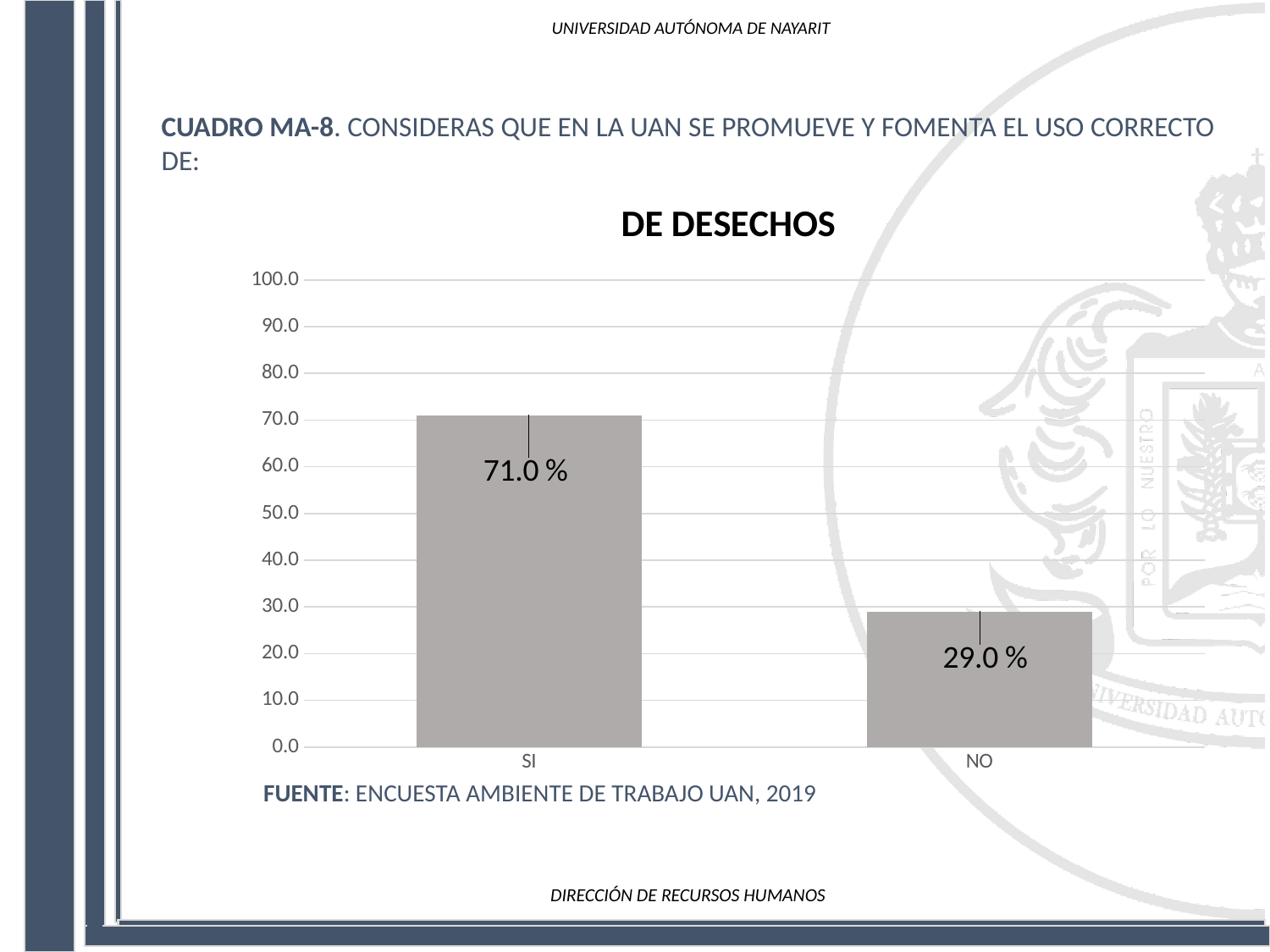
Which category has the lowest value? NO What is the value for SI? 71.0 % What is the difference between the values for SI and NO? 42.0 % Is the value for SI greater or less than 60.0? greater Is the value for NO greater or less than 40.0? less How many categories are shown on the x axis? 2 What is the title of the chart? DE DESECHOS What is the value for NO? 29.0 % Which is larger, the value for SI or the value for NO? SI What is the highest value shown on the y axis? 100.0 Which category has the highest value? SI What kind of chart is shown on the slide? bar chart